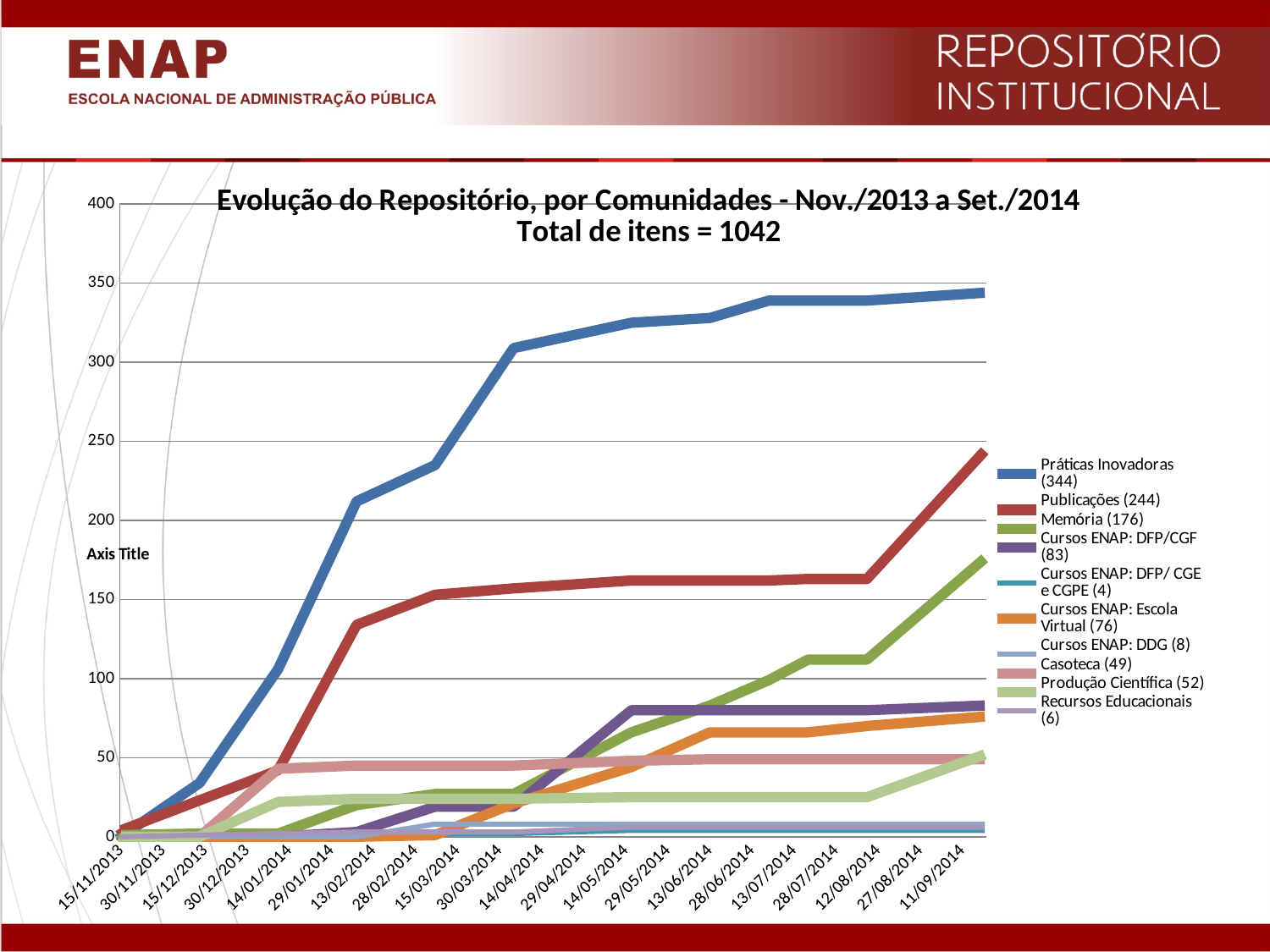
What kind of chart is shown on the slide? line chart Which has the larger legend value, Casoteca or Produção Científica? Produção Científica What value is shown in the legend for Cursos ENAP: Escola Virtual? 76 What total number of items is stated in the chart title? 1042 Does the Práticas Inovadoras line rise or fall from 15/11/2013 to 11/09/2014? rise How many series does the legend list? 10 What value is shown in the legend for Publicações? 244 Is the value for Práticas Inovadoras at 11/09/2014 greater or less than 300? greater Which series has the highest value according to the legend? Práticas Inovadoras (344) What is the difference between the legend values for Práticas Inovadoras and Publicações? 100 How many dates are shown along the x axis? 21 Which series has the lowest value according to the legend? Cursos ENAP: DFP/ CGE e CGPE (4)